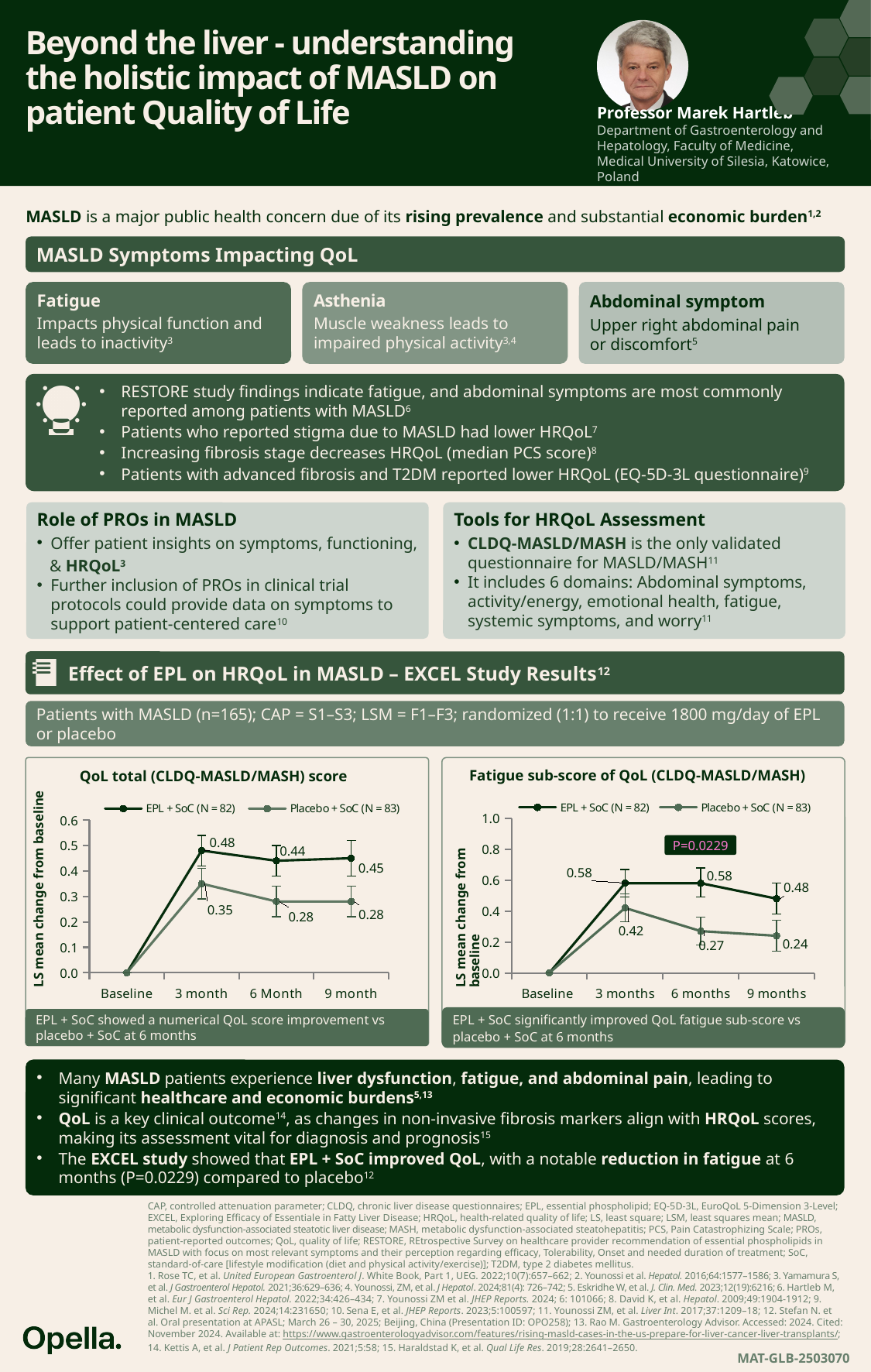
In the 'Fatigue sub-score of QoL (CLDQ-MASLD/MASH)' chart, what is the difference between EPL + SoC and Placebo + SoC at 6 months? 0.31 In the 'Fatigue sub-score of QoL (CLDQ-MASLD/MASH)' chart, what is the value for Placebo + SoC at 6 months? 0.27 In the 'Fatigue sub-score of QoL (CLDQ-MASLD/MASH)' chart, at which time point is the Placebo + SoC value lowest after baseline? 9 months In the 'Fatigue sub-score of QoL (CLDQ-MASLD/MASH)' chart, what P value is shown at 6 months? P=0.0229 In the 'QoL total (CLDQ-MASLD/MASH) score' chart, what is the LS mean change from baseline for EPL + SoC at 3 month? 0.48 In the 'QoL total (CLDQ-MASLD/MASH) score' chart, which series has the higher value at 6 Month, EPL + SoC or Placebo + SoC? EPL + SoC In the 'QoL total (CLDQ-MASLD/MASH) score' chart, what is the difference between EPL + SoC and Placebo + SoC at 9 month? 0.17 In the 'Fatigue sub-score of QoL (CLDQ-MASLD/MASH)' chart, what is the value for EPL + SoC at 9 months? 0.48 In the 'QoL total (CLDQ-MASLD/MASH) score' chart, how many series does the legend list? 2 In the 'Fatigue sub-score of QoL (CLDQ-MASLD/MASH)' chart, how many time points are shown on the x axis? 4 What type of chart is the 'Fatigue sub-score of QoL (CLDQ-MASLD/MASH)' chart? Line chart In the 'QoL total (CLDQ-MASLD/MASH) score' chart, what is the value for Placebo + SoC at 6 Month? 0.28